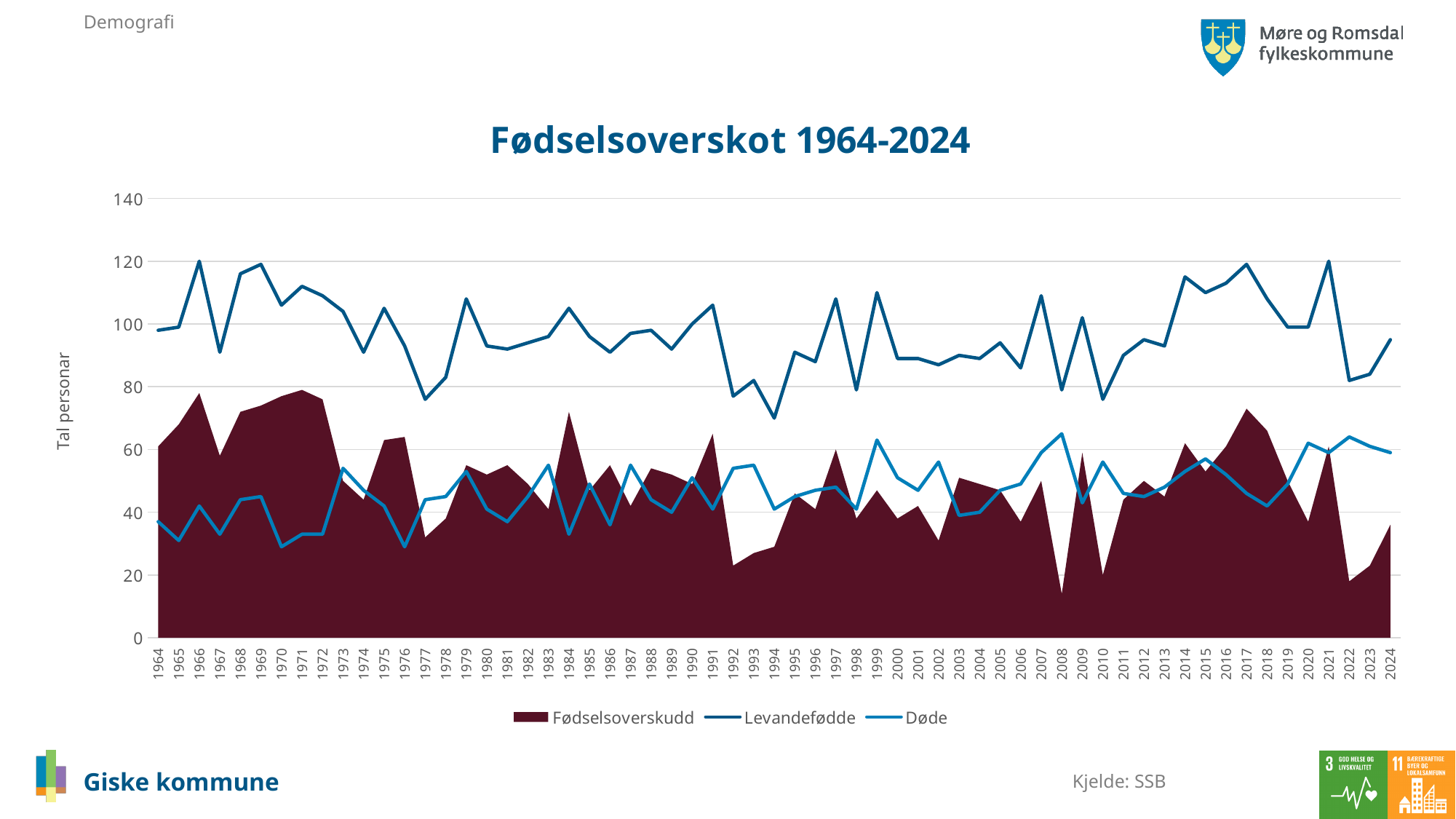
Which is larger in 1966, Levandefødde or Døde? Levandefødde Is the value for Fødselsoverskudd in 2008 greater or less than 20? less Is the value for Døde in 1964 greater or less than 40? less Is the value for Døde in 2008 greater or less than 60? greater How many series does the chart legend list? 3 How many years are plotted along the x axis of the chart? 61 What is the label on the vertical axis of the chart? Tal personar What kind of chart is used to show the Levandefødde series? line chart What is the title of the chart? Fødselsoverskot 1964-2024 Does the Levandefødde series rise or fall from 2021 to 2022? fall